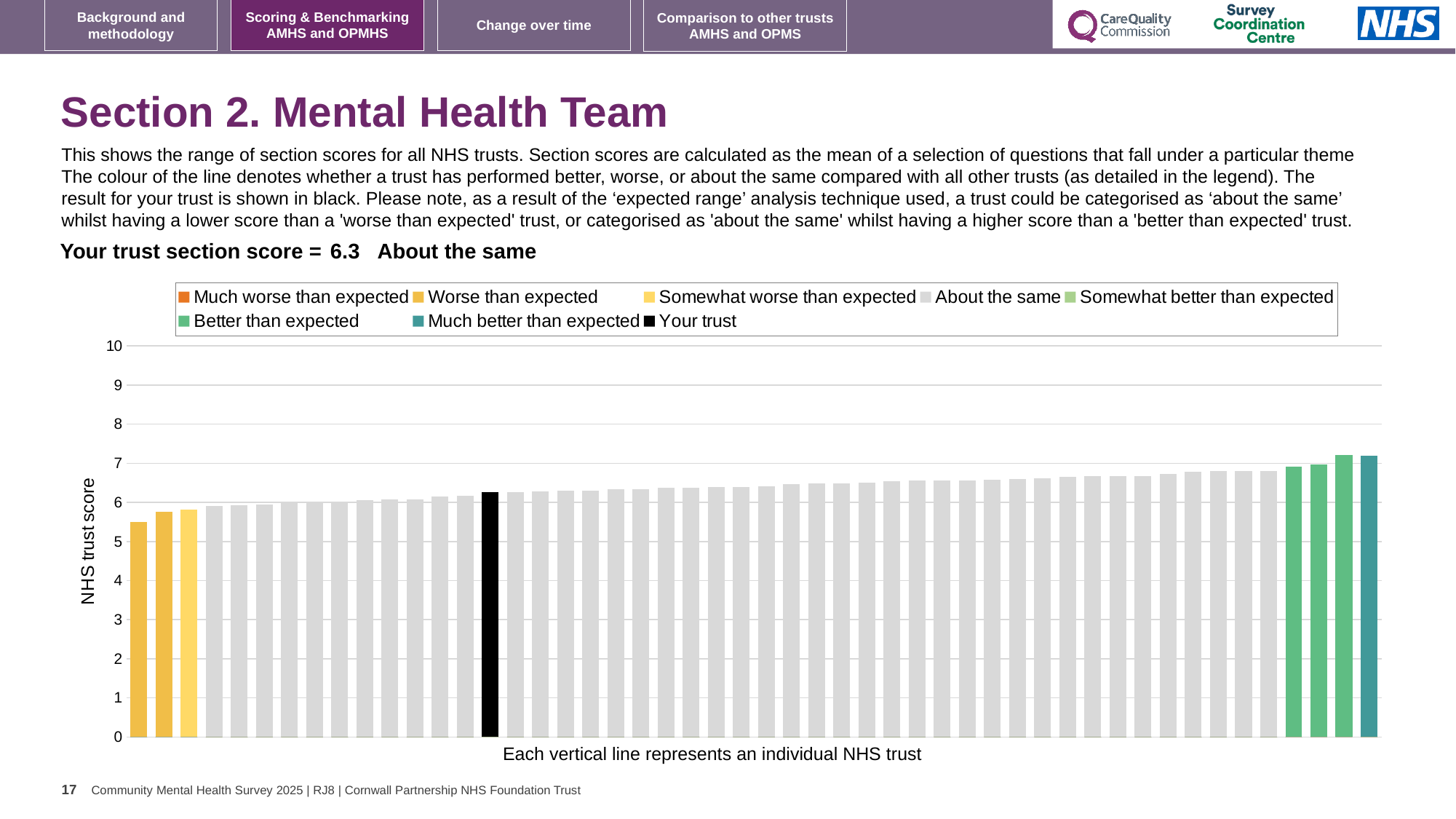
Is the value of the leftmost (lowest) bar greater or less than 5? greater Do the bar values rise or fall from left to right along the x axis? rise Is the value of the black 'Your trust' bar greater or less than 6? greater Which category is your trust placed in according to the slide? About the same Is the value of the tallest bar greater or less than 8? less What kind of chart is shown on the slide? bar chart What is the section score for your trust shown on the slide? 6.3 What is the label of the vertical axis? NHS trust score How many bars are coloured as 'Worse than expected' (yellow)? 2 How many entries does the chart legend list? 8